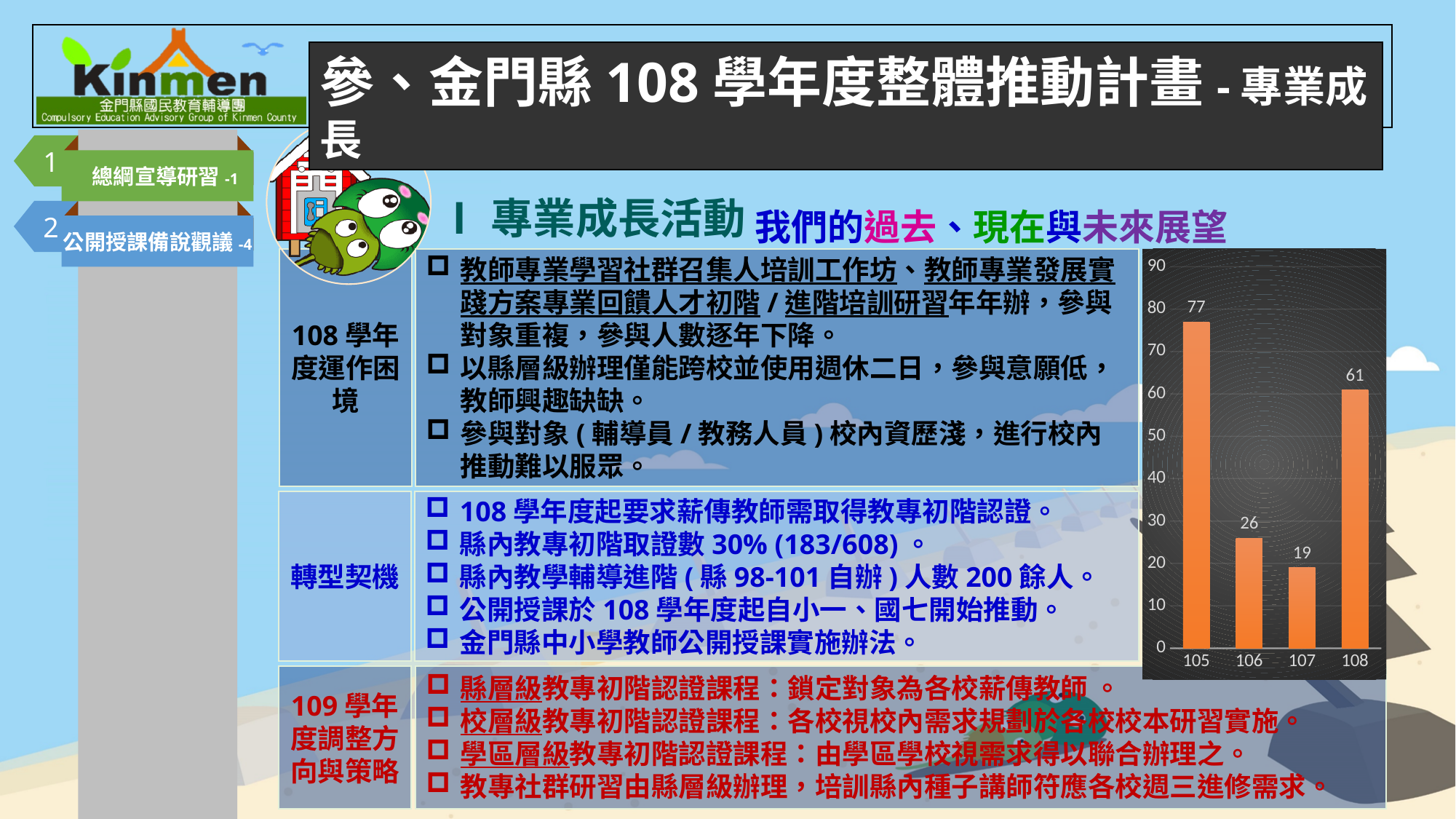
Is the value for 108 greater or less than 50? greater Which category has the lowest value? 107 How many categories are shown on the x axis of the chart? 4 Which is larger, the value for 106 or the value for 108? 108 What is the difference between the values for 105 and 108? 16 What is the value for category 106? 26 What is the difference between the values for 106 and 107? 7 What kind of chart is shown on the slide? bar chart Which category has the highest value? 105 What is the value for category 105? 77 What is the value for category 107? 19 What is the value for category 108? 61